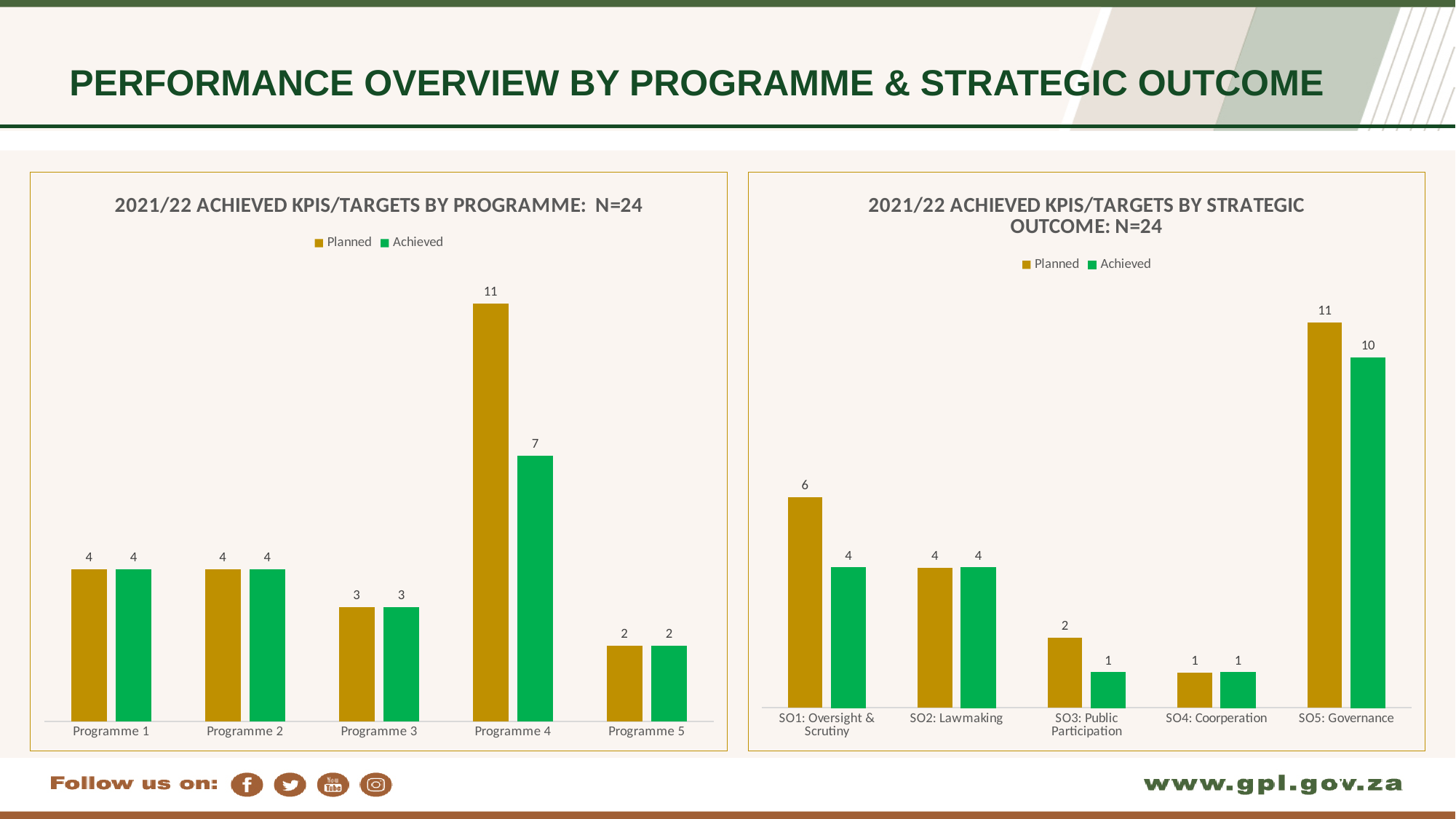
In the right chart (by Strategic Outcome), what is the Achieved value for SO5: Governance? 10 In the left chart (by Programme), what is the difference between Planned and Achieved for Programme 4? 4 In the right chart (by Strategic Outcome), what is the Planned value for SO1: Oversight & Scrutiny? 6 In the left chart (by Programme), how many programmes are shown on the x axis? 5 In the left chart (by Programme), which programme has the lowest Achieved value? Programme 5 What type of chart is the left chart (by Programme)? Bar chart In the right chart (by Strategic Outcome), is the Planned value for SO3: Public Participation larger or smaller than its Achieved value? larger In the right chart (by Strategic Outcome), how many series does the legend list? 2 In the left chart (by Programme), which programme has the highest Planned value? Programme 4 In the left chart (by Programme), what is the Planned value for Programme 4? 11 In the right chart (by Strategic Outcome), which strategic outcome has the lowest Planned value? SO4: Coorperation In the left chart (by Programme), what is the Achieved value for Programme 4? 7